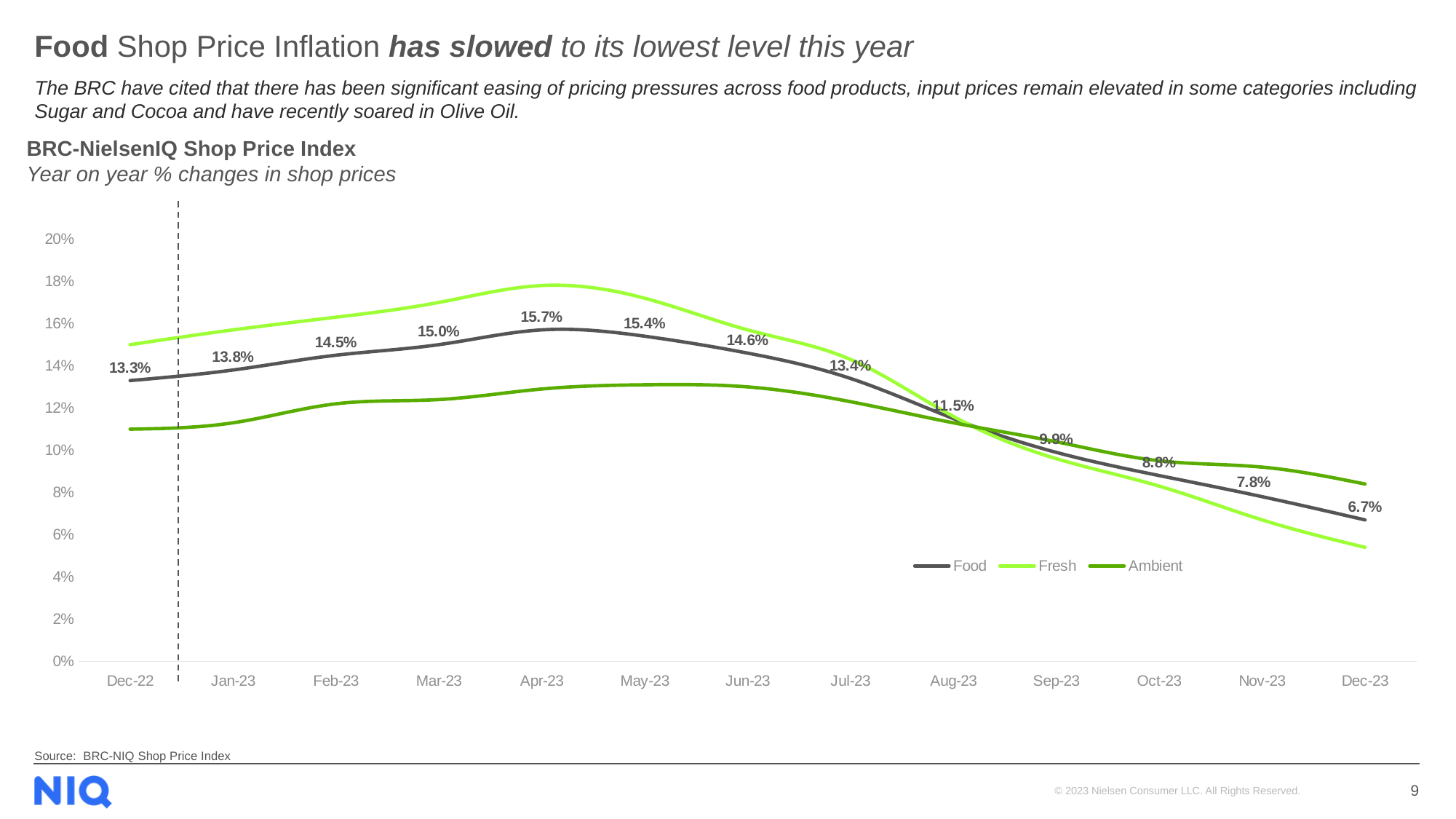
In which month does the Food series reach its highest value? Apr-23 What is the Food value for Dec-23? 6.7% How many months are shown on the x axis? 13 What is the Food value for Apr-23? 15.7% In which month is the Food series at its lowest value? Dec-23 What kind of chart is shown on the slide? Line chart How many series does the legend list? 3 Which is larger, the Food value for Jan-23 or the Food value for Jul-23? Jan-23 Is the Ambient value for Dec-22 greater or less than 12%? less Which series is higher in Dec-23, Fresh or Ambient? Ambient What is the difference between the Food value in Dec-22 and the Food value in Dec-23? 6.6 percentage points Is the Fresh value for Apr-23 greater or less than 16%? greater